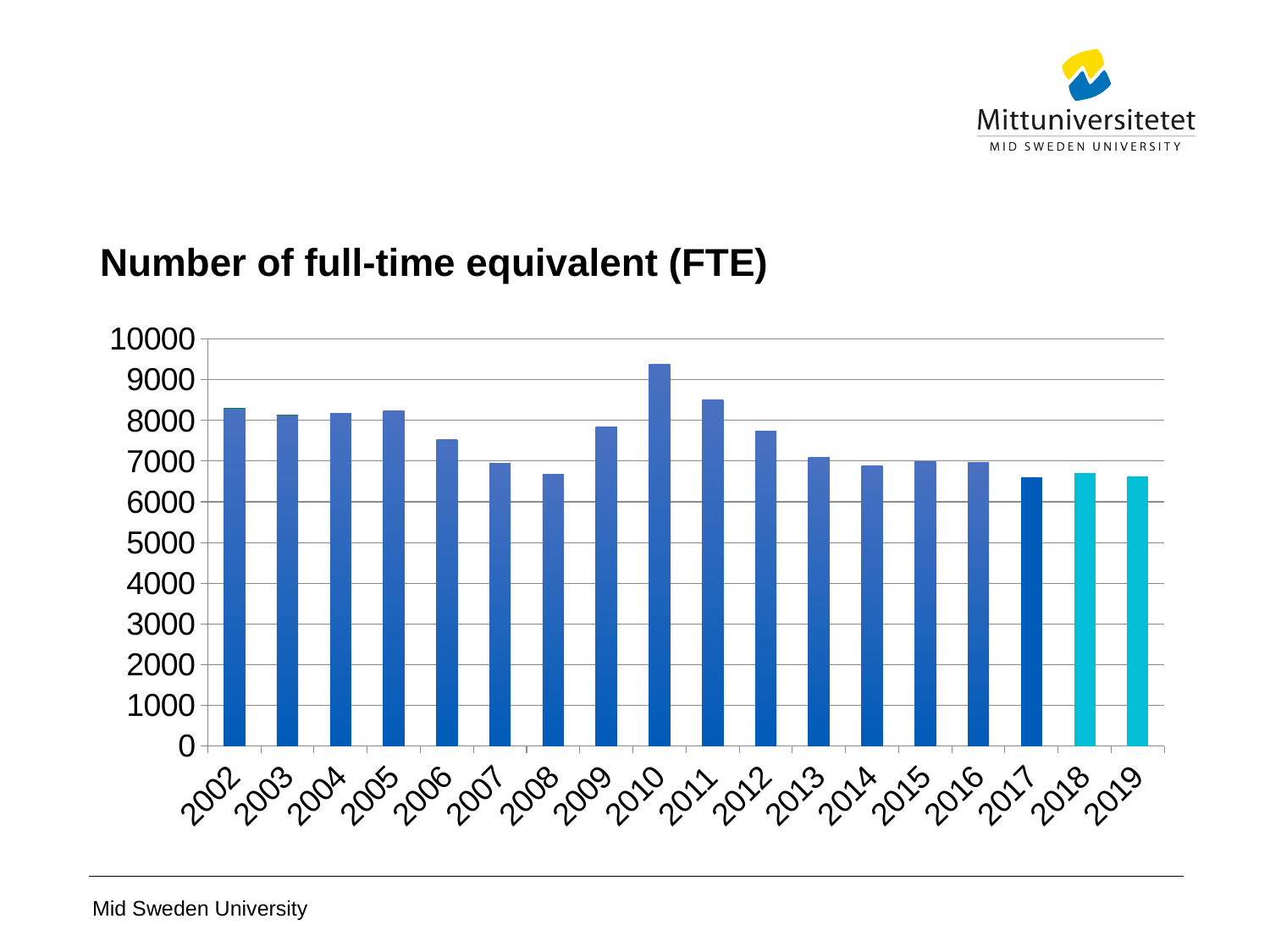
Is the value for 2008 greater or less than 7000? less Is the value for 2010 greater or less than 9000? greater Is the value for 2002 greater or less than 8000? greater What is the title of the chart? Number of full-time equivalent (FTE) Which year has the larger value, 2006 or 2007? 2006 Which year has the larger value, 2010 or 2011? 2010 What kind of chart is shown on the slide? bar chart Do the values rise or fall from 2010 to 2017? fall How many years are shown on the x axis of the chart? 18 Which year has the highest number of full-time equivalents? 2010